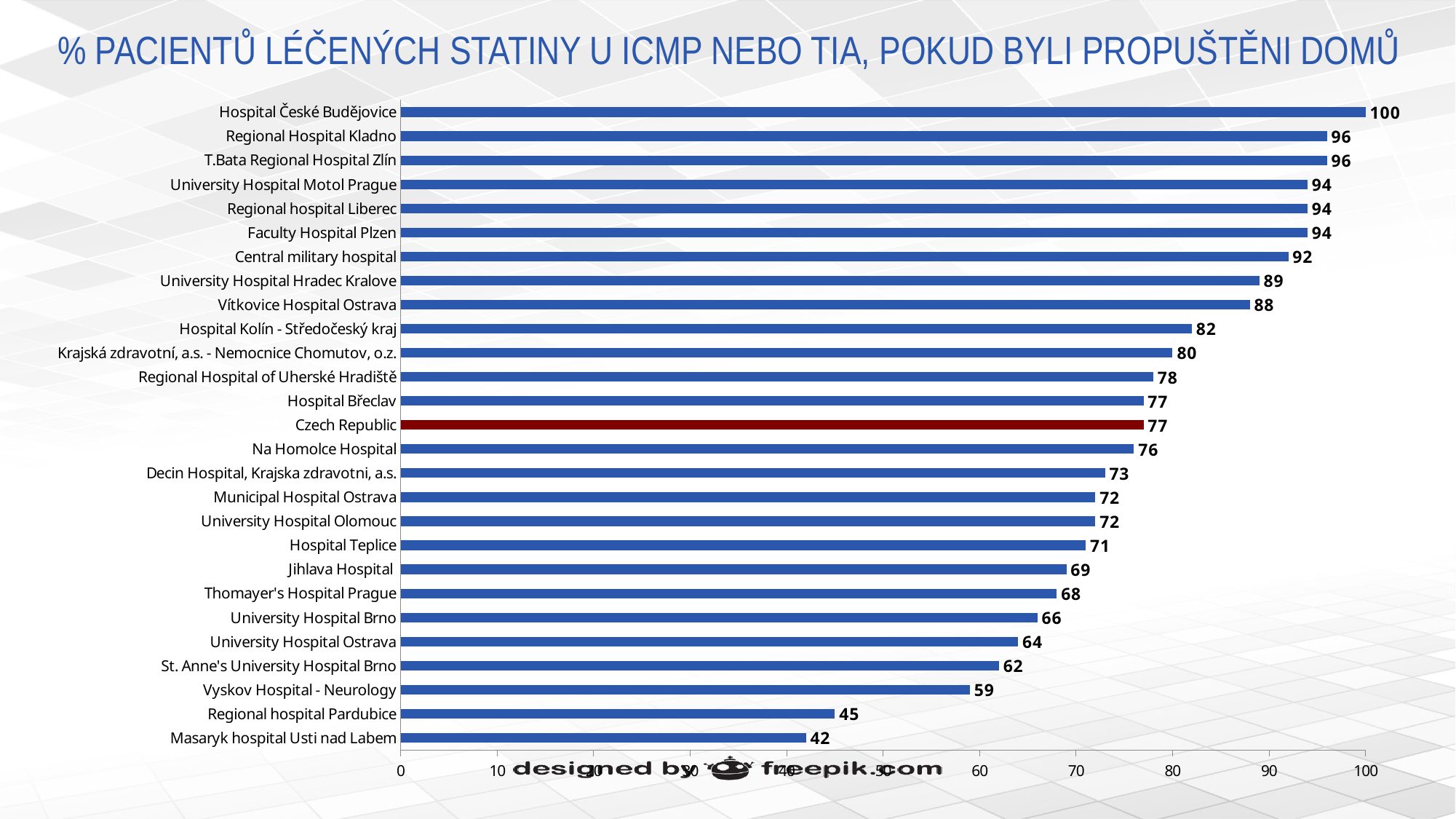
Which has a larger value, University Hospital Brno or Jihlava Hospital? Jihlava Hospital Which bar is shown in a different colour (dark red) from the others? Czech Republic What is the difference between the values for Central military hospital and Hospital Teplice? 21 What is the value for Czech Republic? 77 What is the difference between the values for Hospital České Budějovice and Masaryk hospital Usti nad Labem? 58 How many bars are shown in the chart? 27 Which hospital has the lowest value? Masaryk hospital Usti nad Labem What kind of chart is shown on the slide? bar chart What is the value for Vítkovice Hospital Ostrava? 88 Which hospital has the highest value? Hospital České Budějovice What is the value for Regional hospital Pardubice? 45 Is the value for Vyskov Hospital - Neurology greater or less than 60? less